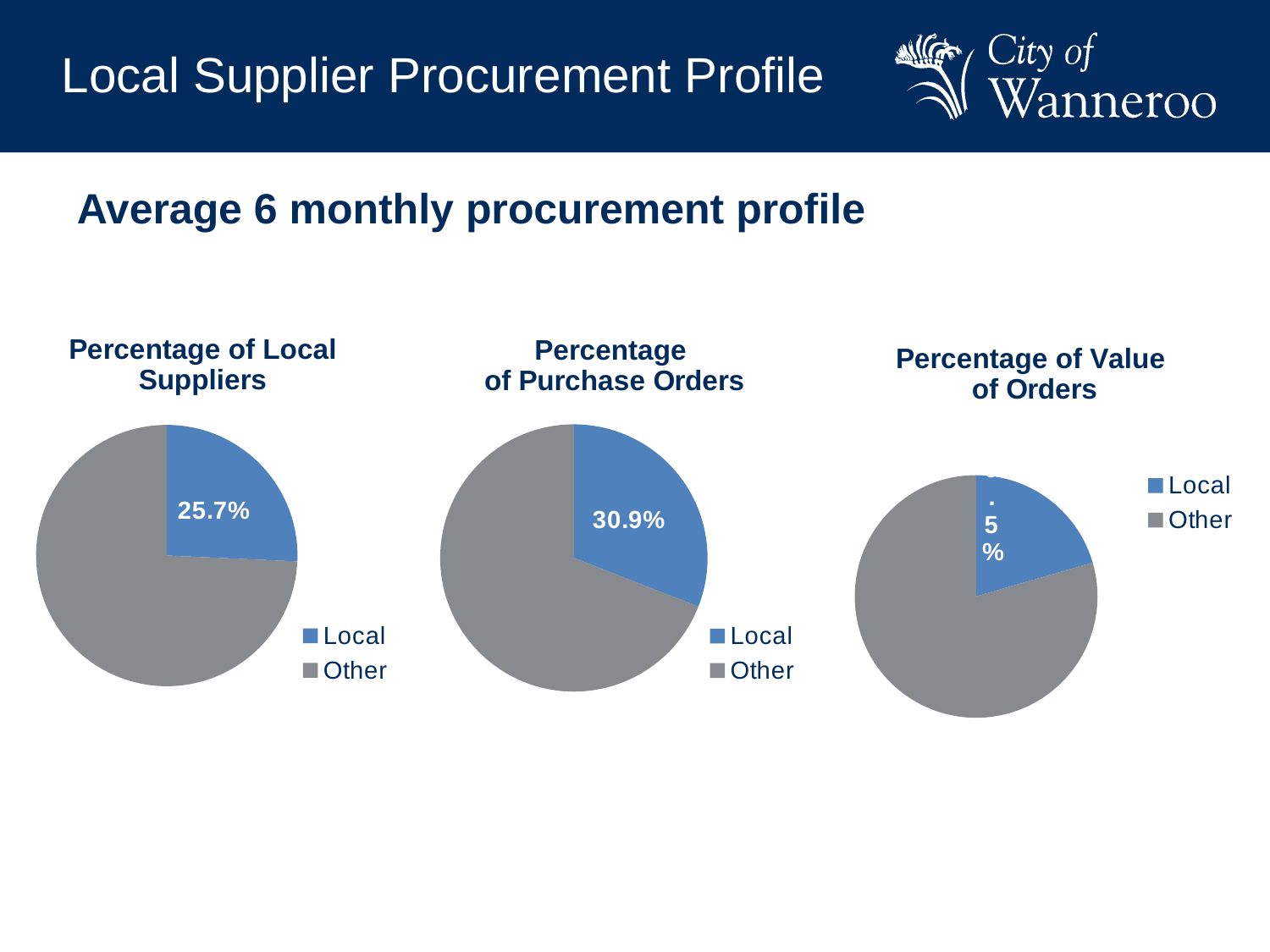
In the 'Percentage of Local Suppliers' chart, what percentage is shown for Local? 25.7% What colour is the Local slice in the 'Percentage of Value of Orders' chart? Blue In the 'Percentage of Local Suppliers' chart, which slice is larger, Local or Other? Other What is the title of the rightmost pie chart on the slide? Percentage of Value of Orders How many slices does the 'Percentage of Purchase Orders' pie chart have? 2 In the 'Percentage of Local Suppliers' chart, what share of the pie does Other take? 74.3% Is the Local percentage higher in the 'Percentage of Local Suppliers' chart or in the 'Percentage of Purchase Orders' chart? Percentage of Purchase Orders By how many percentage points does the Local share in the 'Percentage of Purchase Orders' chart exceed the Local share in the 'Percentage of Local Suppliers' chart? 5.2 percentage points How many entries does the legend of the 'Percentage of Purchase Orders' chart list? 2 In the 'Percentage of Purchase Orders' chart, what percentage is shown for Local? 30.9% In the 'Percentage of Value of Orders' chart, which slice is larger, Local or Other? Other What type of chart is the 'Percentage of Local Suppliers' chart? Pie chart